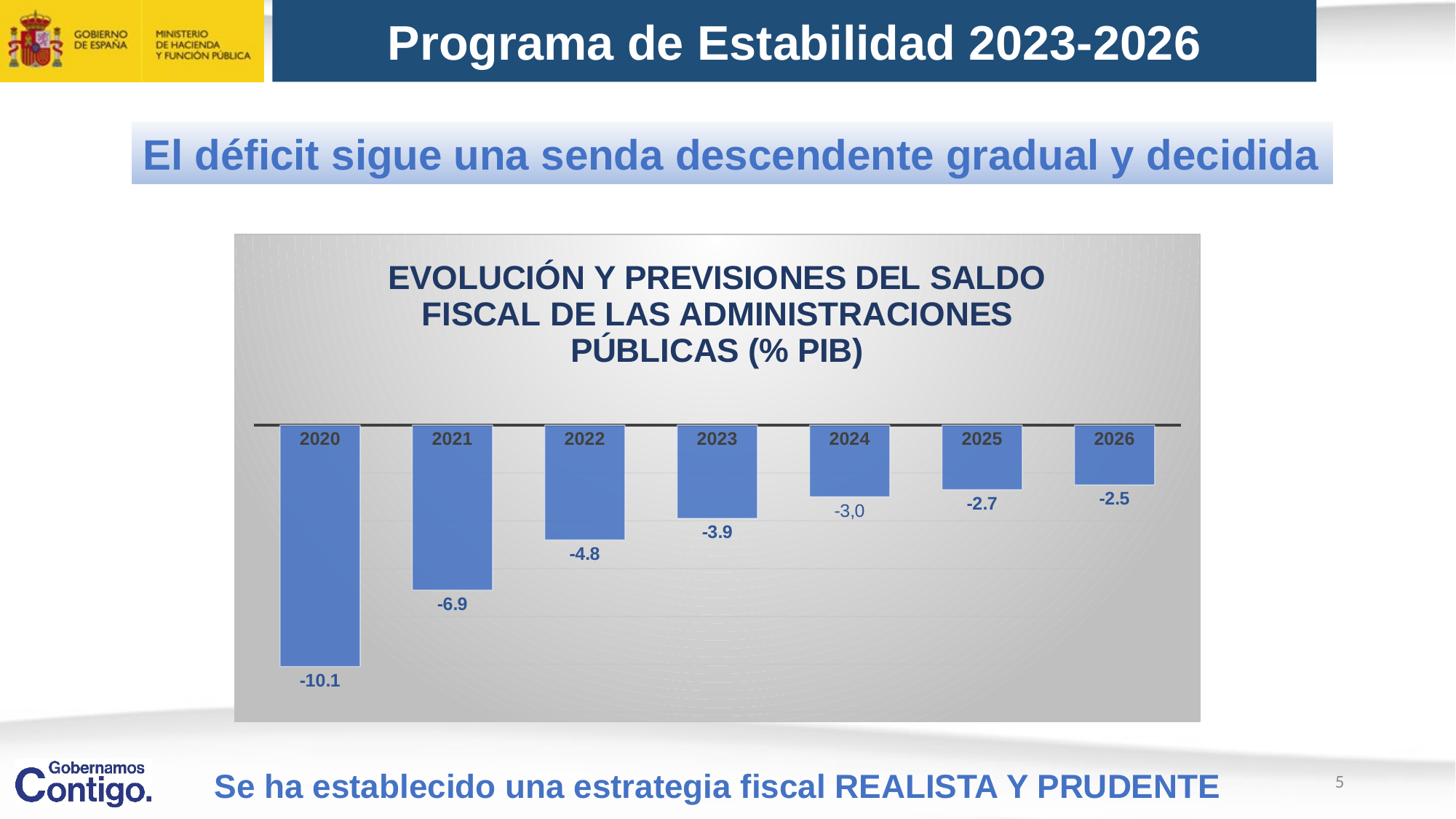
How many years are shown in the chart? 7 Which year has the lowest (most negative) value? 2020 What is the value for 2026? -2.5 Which is larger (less negative), the value for 2022 or the value for 2023? 2023 What is the value for 2024? -3,0 What is the value for 2020? -10.1 Which year has the highest (least negative) value? 2026 Do the values rise or fall from 2020 to 2026? Rise What is the difference between the values for 2025 and 2026? 0.2 What is the difference between the values for 2020 and 2021? 3.2 What kind of chart is shown on the slide? Bar chart What is the value for 2022? -4.8